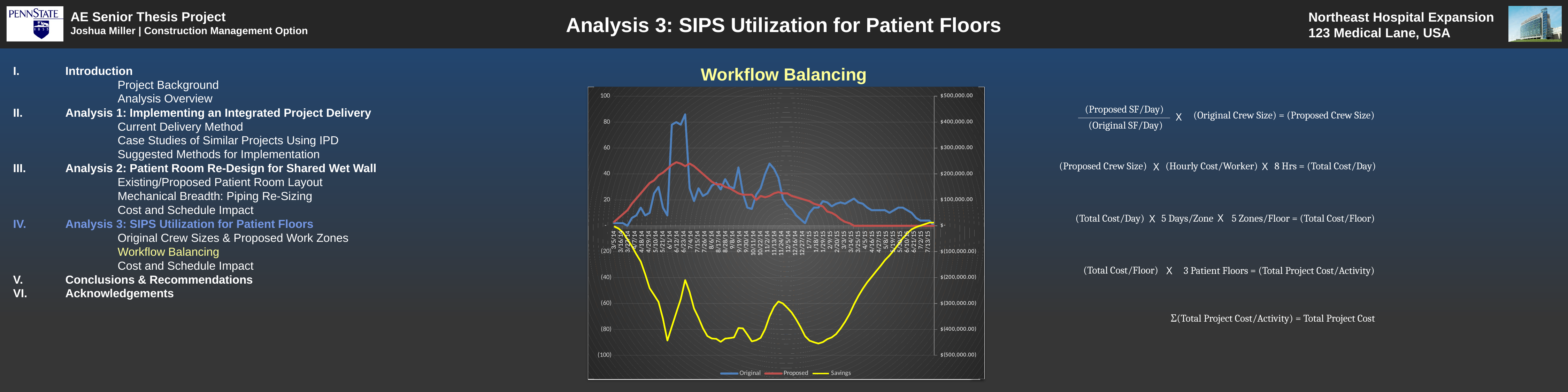
Is the Savings series above or below zero for most of the chart? below What is the highest tick value shown on the right-hand axis of the chart? $500,000.00 What are the three series named in the chart's legend? Original, Proposed, Savings Does the Proposed series rise or fall between 3/5/14 and 5/21/14? rise What is the title shown above the chart? Workflow Balancing How many series does the chart's legend list? 3 Which series reaches a higher peak, Original or Proposed? Original Does the Proposed series rise or fall between 1/7/15 and 7/13/15? fall Is the highest point of the Original series greater or less than 80 on the left axis? greater Is the lowest point of the Savings series greater or less than (60) on the left axis? less What kind of chart is shown on the slide? line chart Is the highest point of the Proposed series greater or less than 60 on the left axis? less